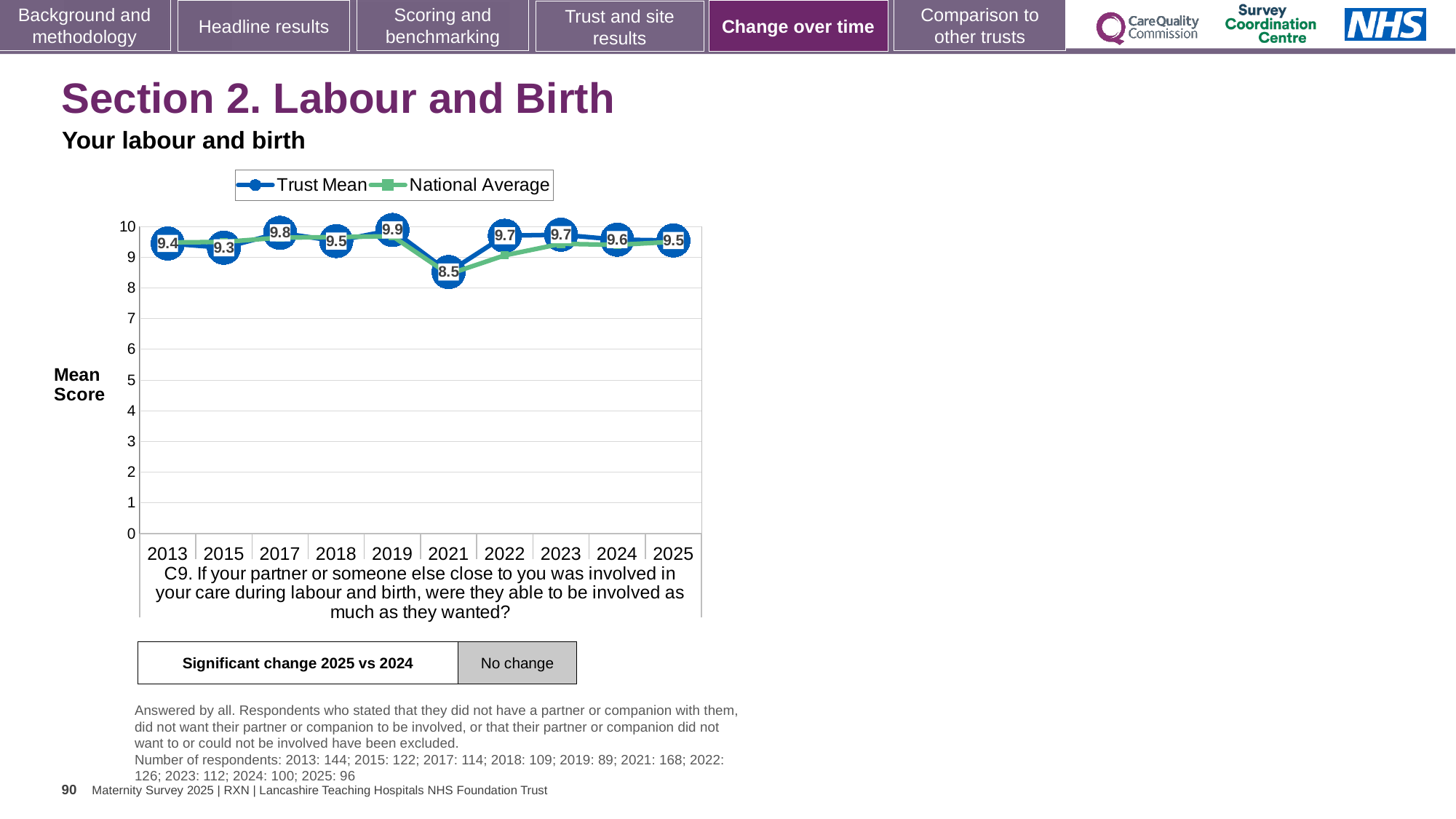
In which year is the Trust Mean score lowest? 2021 Which year has the larger Trust Mean score, 2017 or 2018? 2017 What is the Trust Mean score for 2019? 9.9 Is the National Average for 2021 greater or less than 8? greater In which year is the Trust Mean score highest? 2019 What is the difference between the Trust Mean scores for 2019 and 2021? 1.4 Did the Trust Mean score rise or fall from 2024 to 2025? Fall What is the Trust Mean score for 2025? 9.5 How many series does the chart legend list? 2 What kind of chart is shown on the slide? Line chart How many years are shown on the x axis of the chart? 10 What is the Trust Mean score for 2021? 8.5